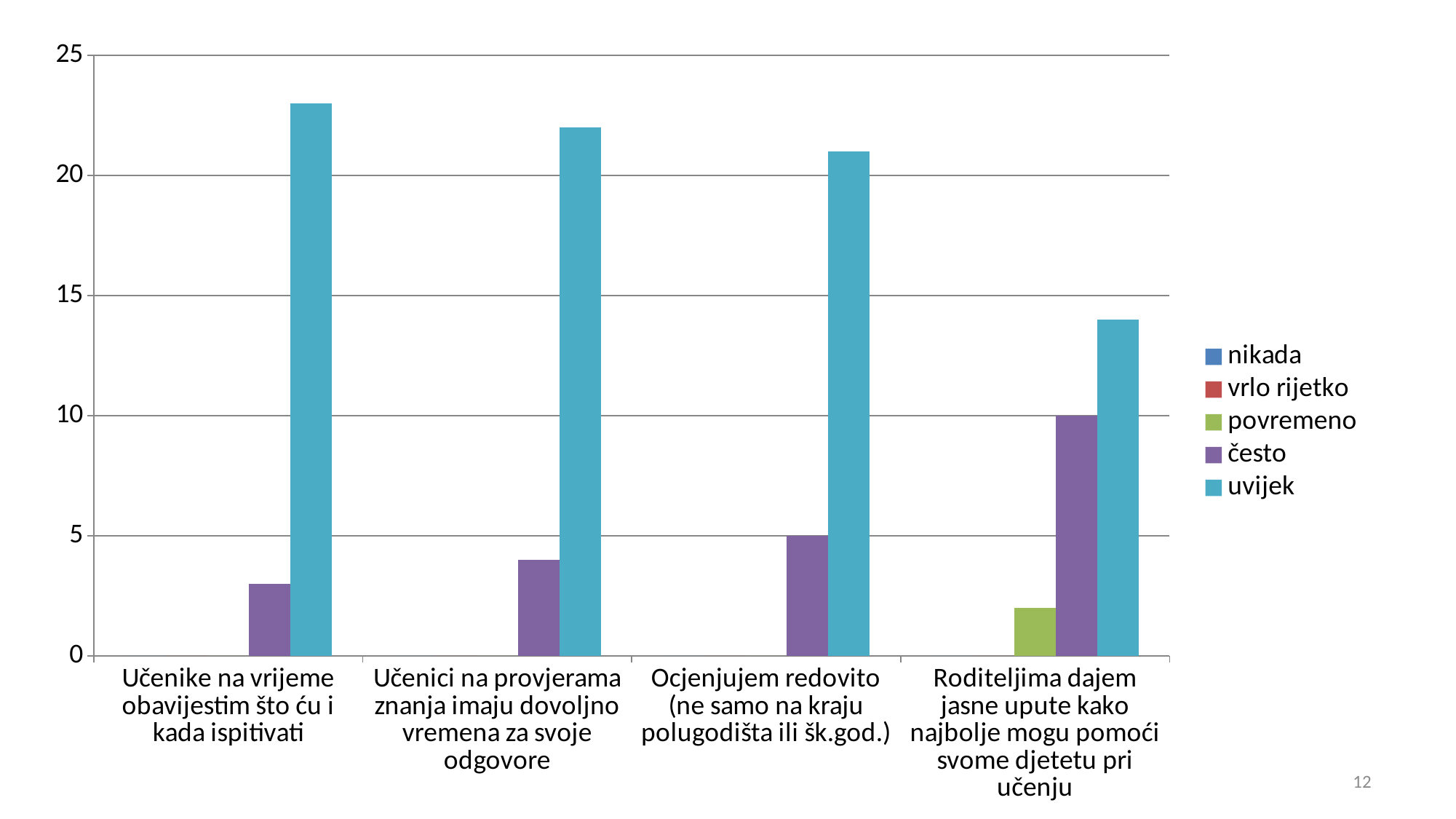
Which is larger for "Roditeljima dajem jasne upute kako najbolje mogu pomoći svome djetetu pri učenju": "često" or "uvijek"? uvijek How many series does the legend list? 5 Is the value of "često" for "Učenici na provjerama znanja imaju dovoljno vremena za svoje odgovore" greater or less than 5? less What kind of chart is shown on the slide? bar chart What is the value of "često" for "Ocjenjujem redovito (ne samo na kraju polugodišta ili šk.god.)"? 5 What is the value of "često" for "Roditeljima dajem jasne upute kako najbolje mogu pomoći svome djetetu pri učenju"? 10 Which category has the lowest "uvijek" value? Roditeljima dajem jasne upute kako najbolje mogu pomoći svome djetetu pri učenju How many categories are shown on the x axis? 4 Is the value of "uvijek" for "Roditeljima dajem jasne upute kako najbolje mogu pomoći svome djetetu pri učenju" greater or less than 15? less Is the value of "uvijek" for "Učenike na vrijeme obavijestim što ću i kada ispitivati" greater or less than 20? greater Do the "uvijek" values rise or fall from left to right along the x axis? fall Which category has the highest "uvijek" value? Učenike na vrijeme obavijestim što ću i kada ispitivati